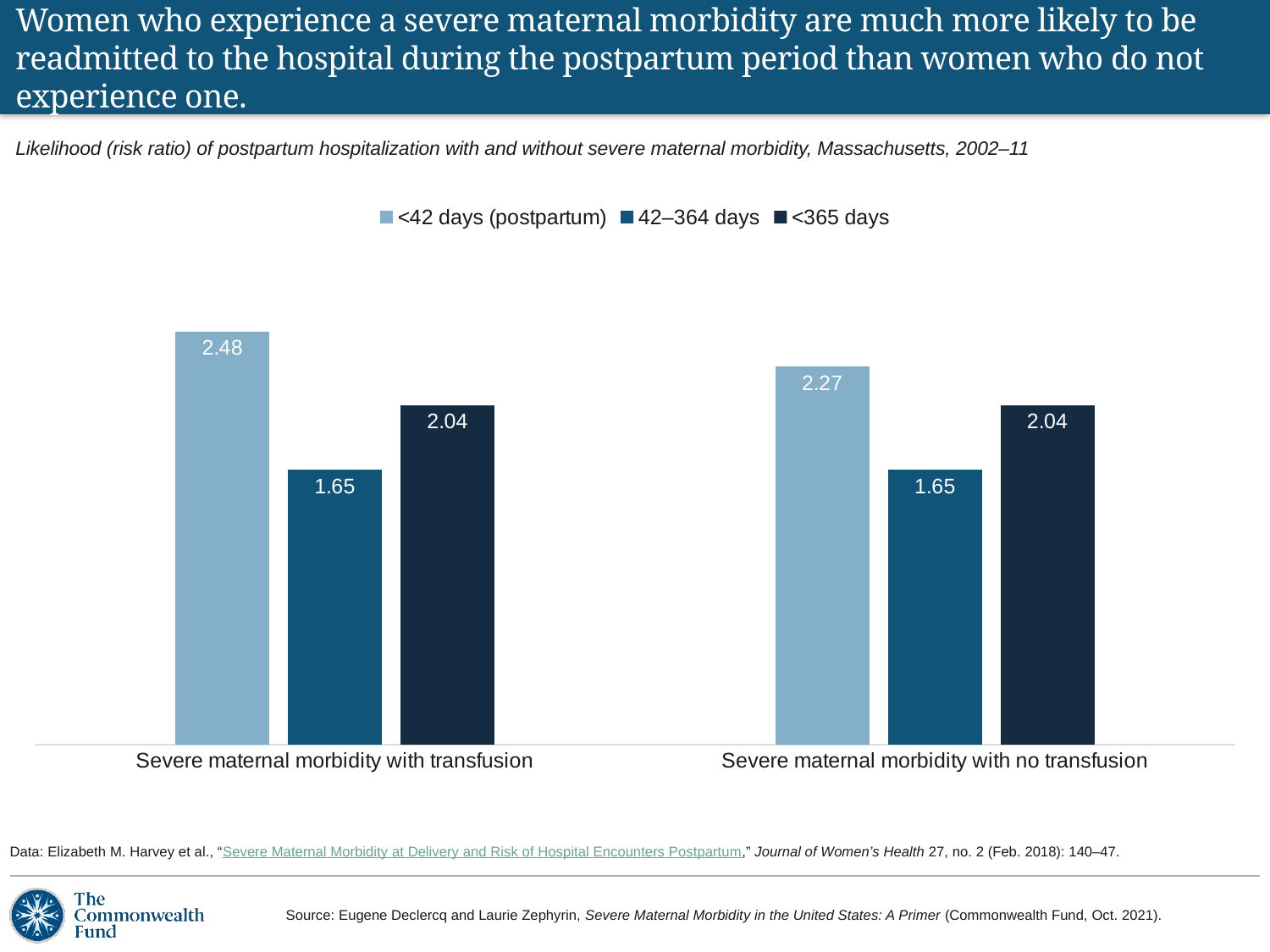
How many series does the legend list? 3 Which series has the highest value for severe maternal morbidity with transfusion? <42 days (postpartum) What is the risk ratio for 42–364 days for severe maternal morbidity with transfusion? 1.65 What is the risk ratio for <42 days (postpartum) for severe maternal morbidity with transfusion? 2.48 What is the risk ratio for <42 days (postpartum) for severe maternal morbidity with no transfusion? 2.27 Which is larger: the <42 days (postpartum) value for severe maternal morbidity with transfusion or with no transfusion? Severe maternal morbidity with transfusion Which series has the lowest value for severe maternal morbidity with no transfusion? 42–364 days What kind of chart is shown on the slide? Bar chart What is the difference between the <42 days (postpartum) values for severe maternal morbidity with transfusion and with no transfusion? 0.21 What is the risk ratio for <365 days for severe maternal morbidity with no transfusion? 2.04 How many categories are shown on the x axis? 2 What is the difference between the <42 days (postpartum) and 42–364 days values for severe maternal morbidity with transfusion? 0.83